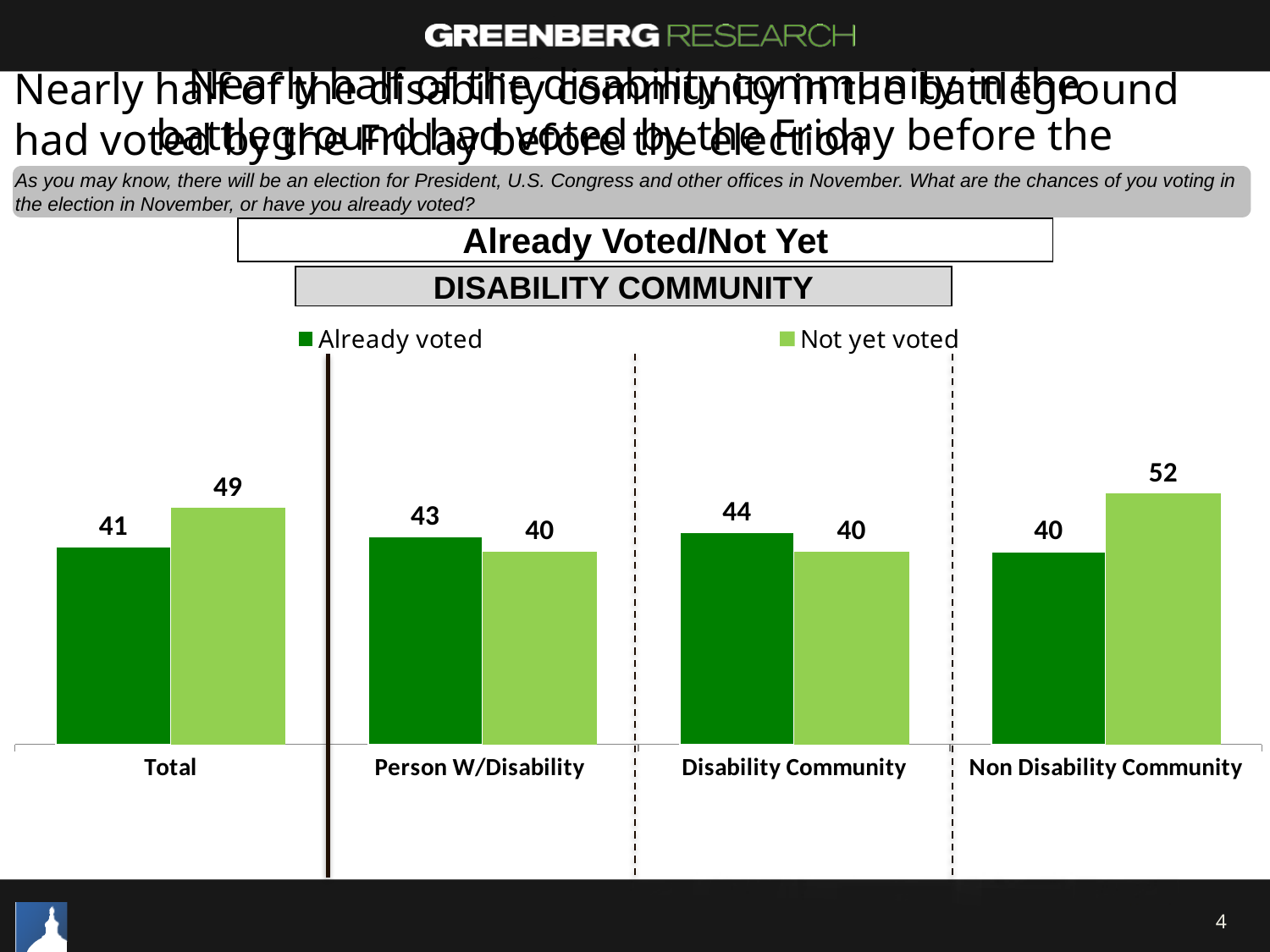
What are the two series named in the legend? Already voted and Not yet voted What is the value for Already voted in the Disability Community category? 44 Which is larger in the Disability Community category, Already voted or Not yet voted? Already voted What is the value for Already voted in the Total category? 41 What is the value for Not yet voted in the Person W/Disability category? 40 What is the value for Not yet voted in the Non Disability Community category? 52 What kind of chart is shown on the slide? Bar chart How many series does the legend list? 2 Which category has the lowest Already voted value? Non Disability Community What is the difference between Not yet voted and Already voted in the Total category? 8 How many categories are shown on the x axis? 4 Which category has the highest Not yet voted value? Non Disability Community